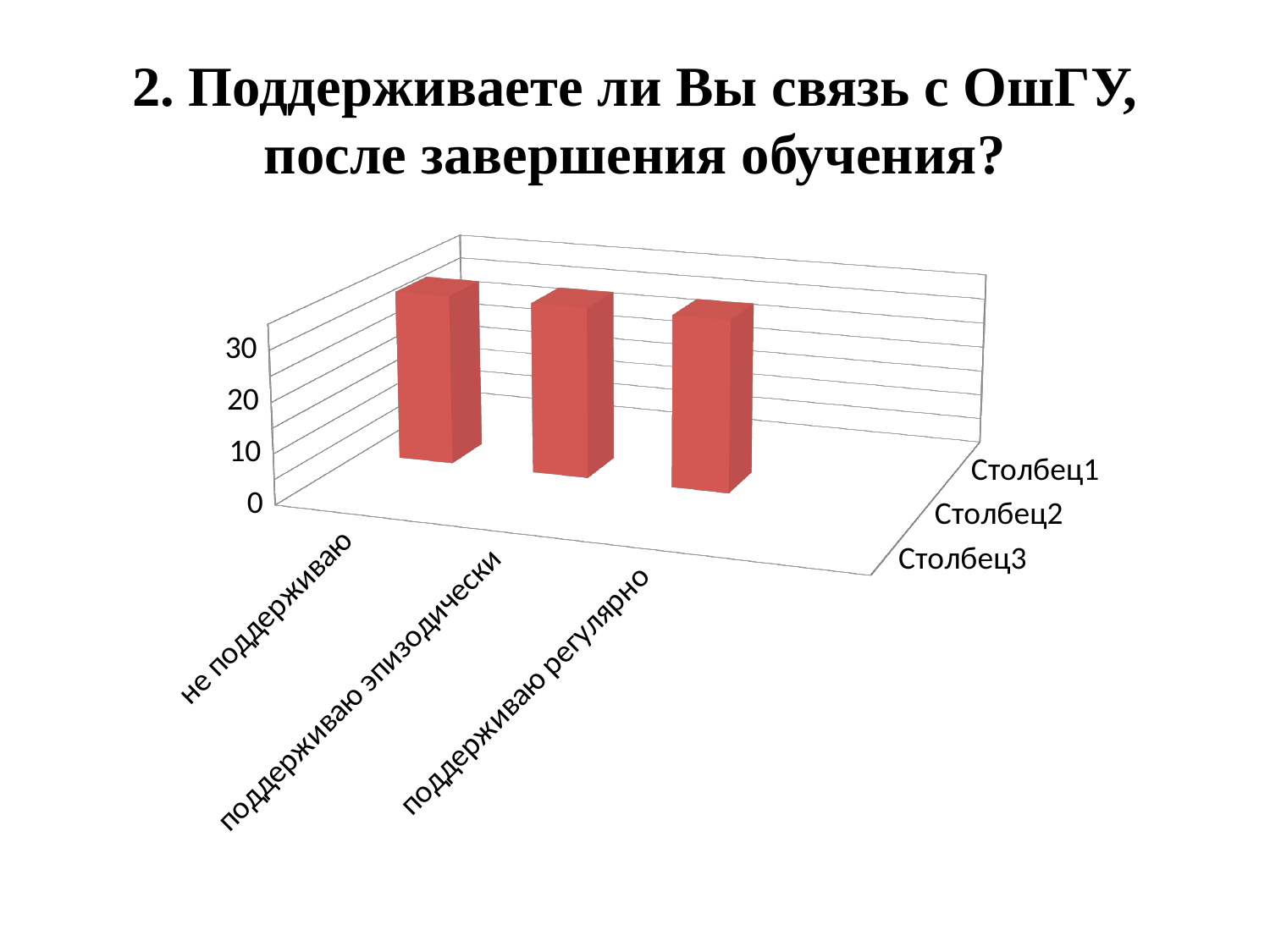
What is the title of the chart on the slide? 2. Поддерживаете ли Вы связь с ОшГУ, после завершения обучения? Is the value for "поддерживаю регулярно" greater or less than 10? greater What is the label of the last category on the category axis? поддерживаю регулярно Is the value for "не поддерживаю" greater or less than 10? greater How many categories are shown on the chart's category axis? 3 What is the label of the first category on the category axis? не поддерживаю What kind of chart is shown on the slide? bar chart What is the highest tick value shown on the vertical axis? 30 Is the value for "поддерживаю эпизодически" greater or less than 20? greater